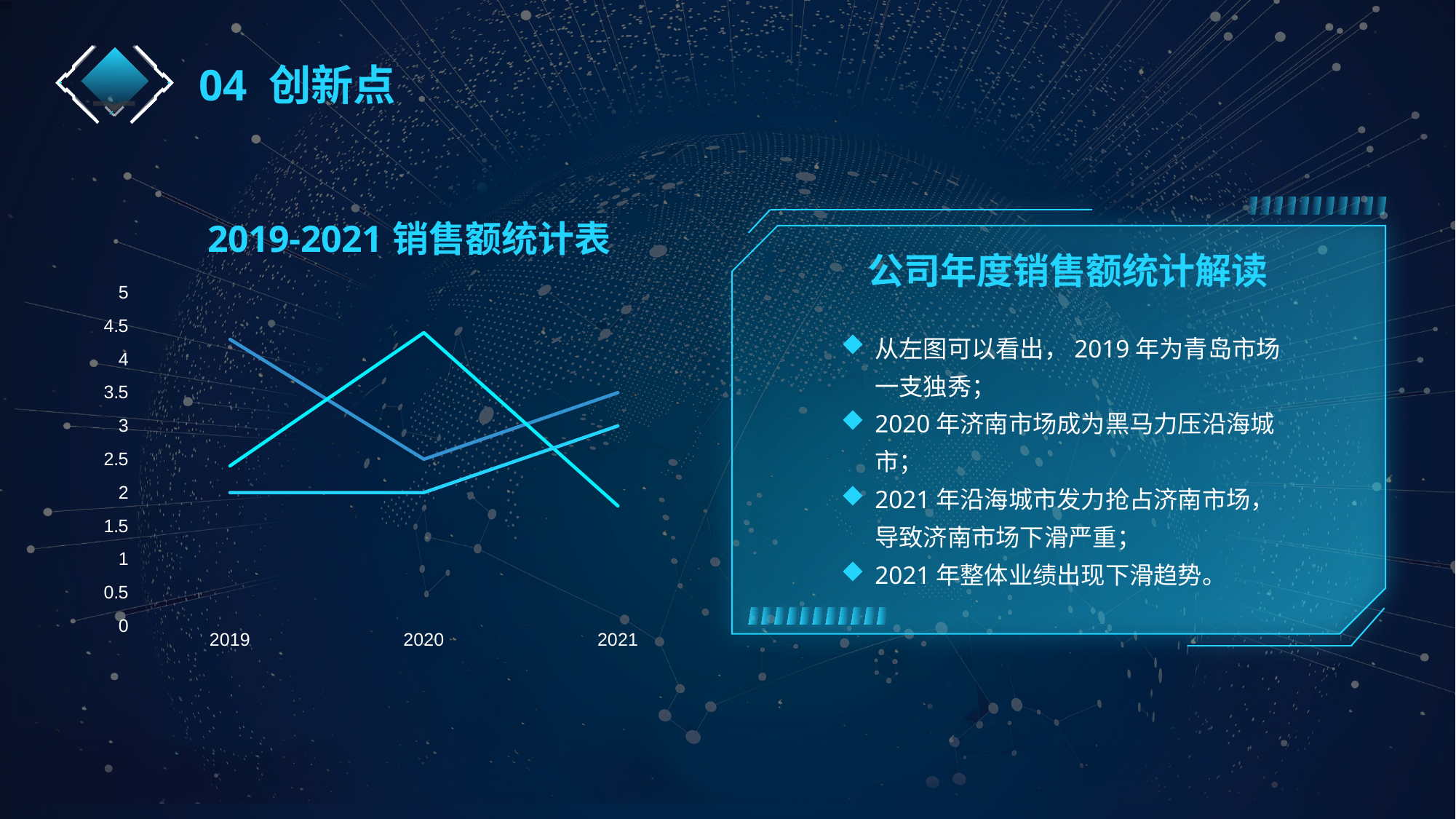
Is the highest value plotted for 2020 greater or less than 4? greater What is the maximum value shown on the y axis of the chart? 5 Is the lowest value plotted for 2019 greater or less than 3? less Is the lowest value plotted for 2020 greater or less than 3? less What kind of chart is shown on the slide? line chart What is the title of the chart? 2019-2021 销售额统计表 How many years are shown on the x axis of the chart? 3 How many lines are plotted on the chart? 3